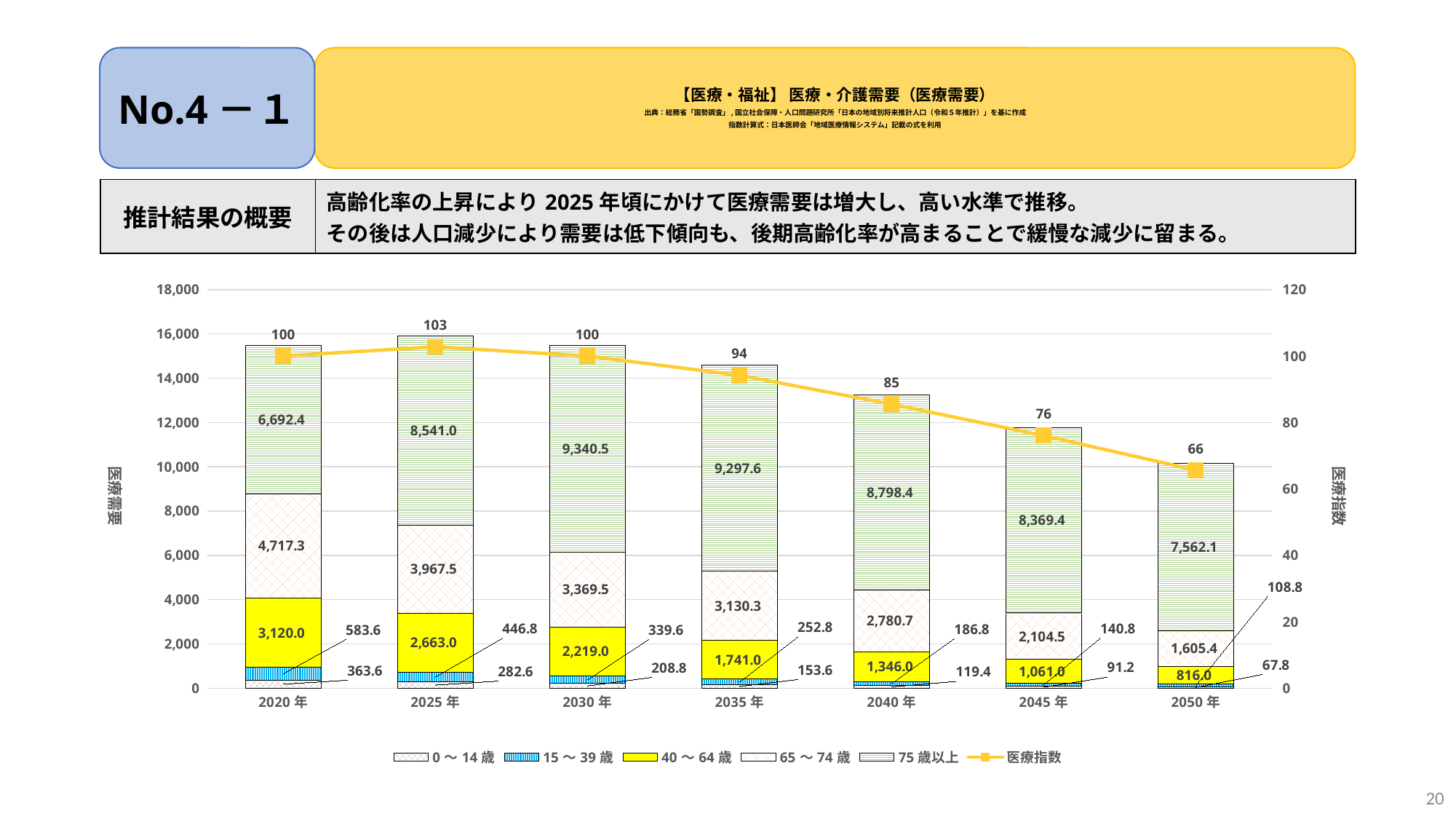
What is the 医療指数 value for 2040年? 85 Does the 0～14歳 series rise or fall from 2020年 to 2050年? fall What is the difference between the 75歳以上 values for 2030年 and 2020年? 2,648.1 In which year does the 医療指数 line reach its highest value? 2025年 Which is larger, the 65～74歳 value for 2020年 or the 65～74歳 value for 2035年? 2020年 How many series does the legend list? 6 What is the value of the 75歳以上 series for 2025年? 8,541.0 How many years are shown on the x axis? 7 Is the total height of the stacked bar for 2045年 greater or less than 10,000? greater What is the total of the stacked bar for 2020年? 15,476.9 What is the value of the 40～64歳 series for 2050年? 816.0 In which year is the 医療指数 value lowest? 2050年